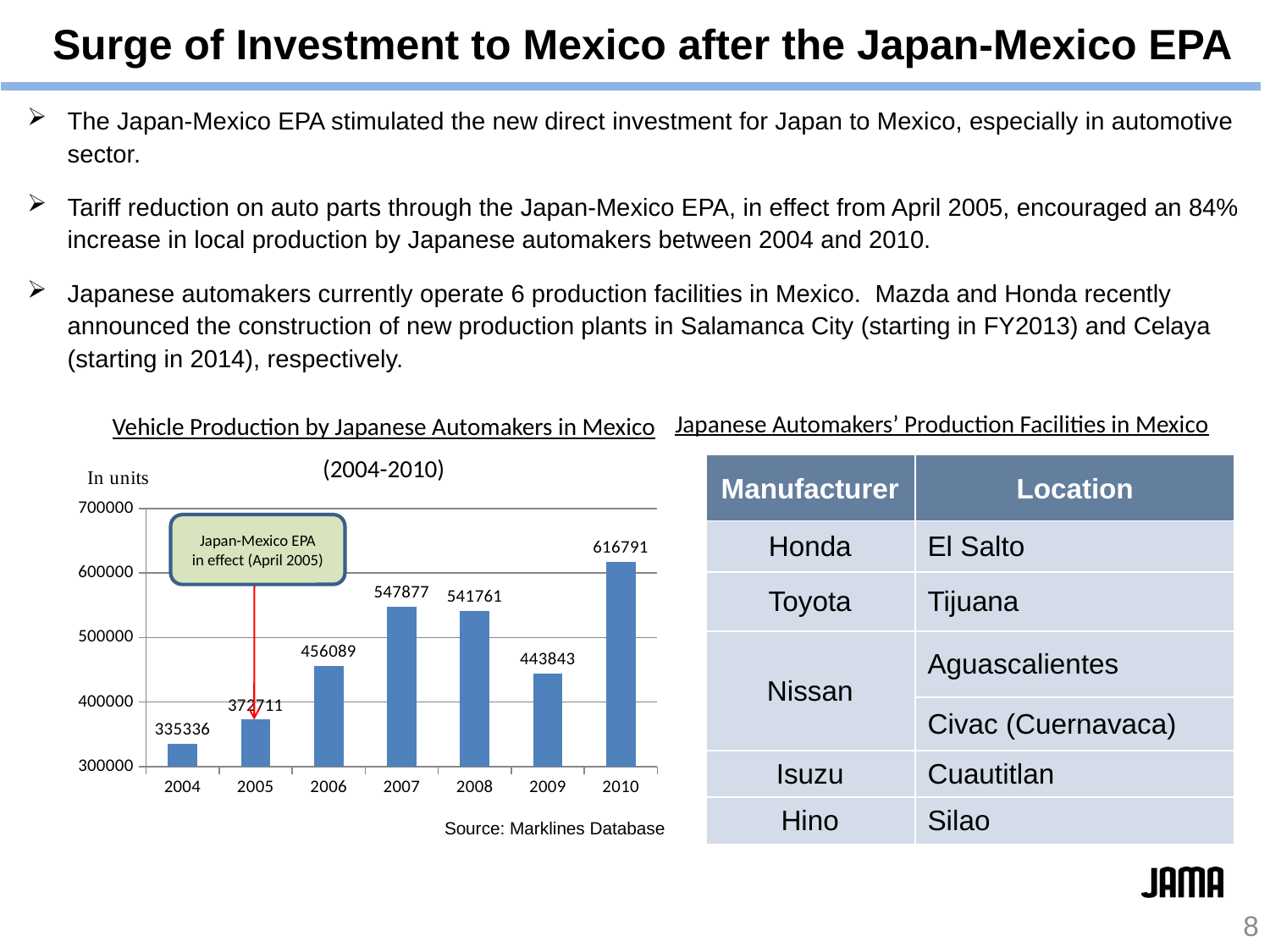
What is the difference in vehicle production between 2010 and 2004? 281455 How many years are shown on the x axis of the vehicle production chart? 7 What event does the callout box in the chart mark? Japan-Mexico EPA in effect (April 2005) Which year has the lowest vehicle production in the chart? 2004 Is the value for 2008 greater or less than 500000? greater What value is shown for 2009 in the vehicle production chart? 443843 What was vehicle production by Japanese automakers in Mexico in 2010? 616791 What kind of chart is used to show vehicle production by Japanese automakers in Mexico? Bar chart What value is shown for 2007 in the vehicle production chart? 547877 Which year had higher vehicle production, 2006 or 2009? 2006 What was vehicle production by Japanese automakers in Mexico in 2004? 335336 Which year has the highest vehicle production in the chart? 2010